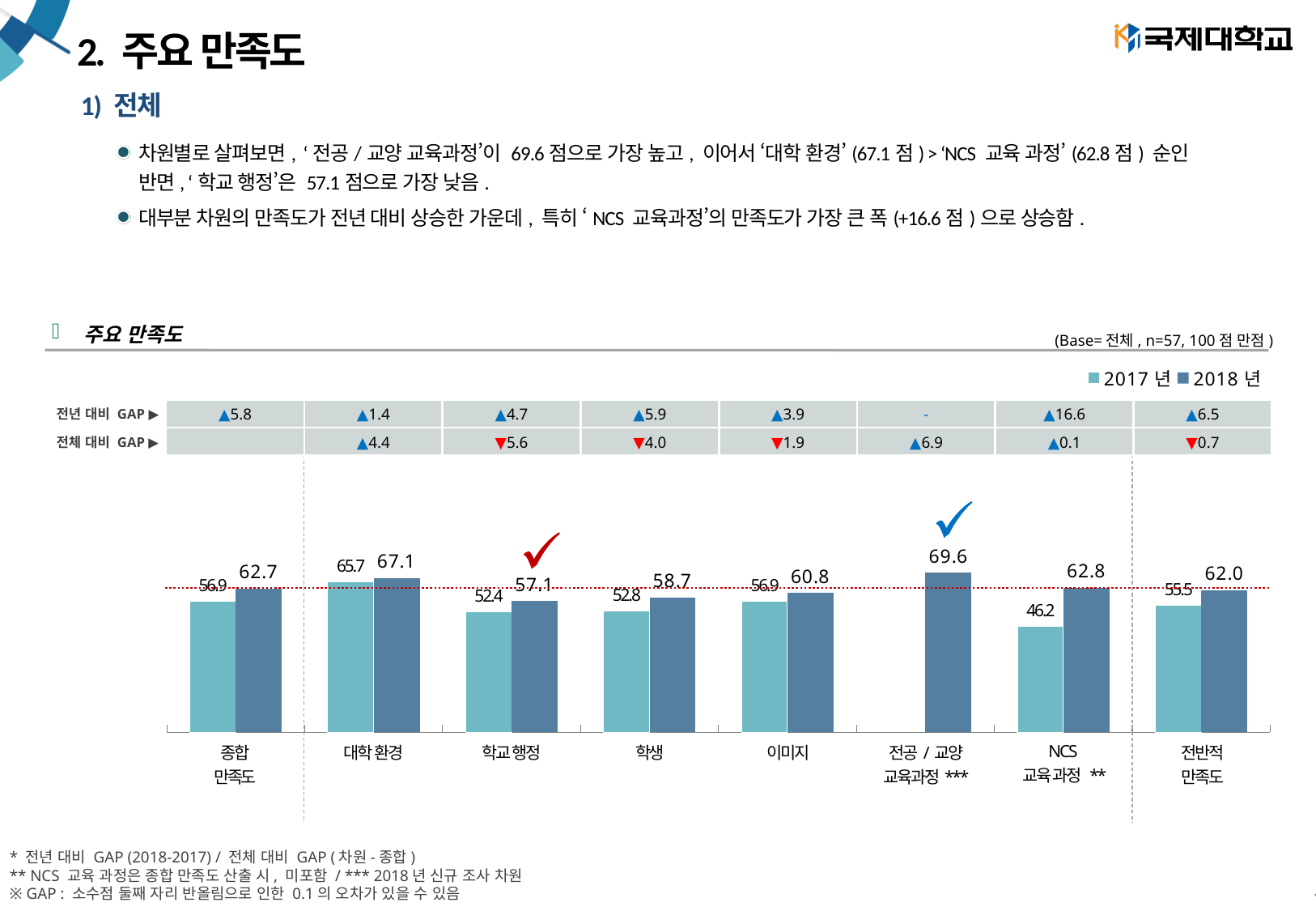
What is the 2017년 value for NCS 교육과정? 46.2 What is the 2018년 value for 학교 행정? 57.1 What is the 2018년 value for 전공 / 교양 교육과정? 69.6 How many series does the legend list? 2 What are the two legend entries of the chart? 2017년, 2018년 What kind of chart is shown on the slide? bar chart What is the 2017년 value for 대학 환경? 65.7 Which category has the highest 2018년 value? 전공 / 교양 교육과정 How many categories are shown on the x axis? 8 What is the difference between the 2018년 and 2017년 values for NCS 교육과정? 16.6 Which category has the lowest 2017년 value? NCS 교육과정 Which is larger, the 2018년 value for 학생 or the 2018년 value for 이미지? 이미지